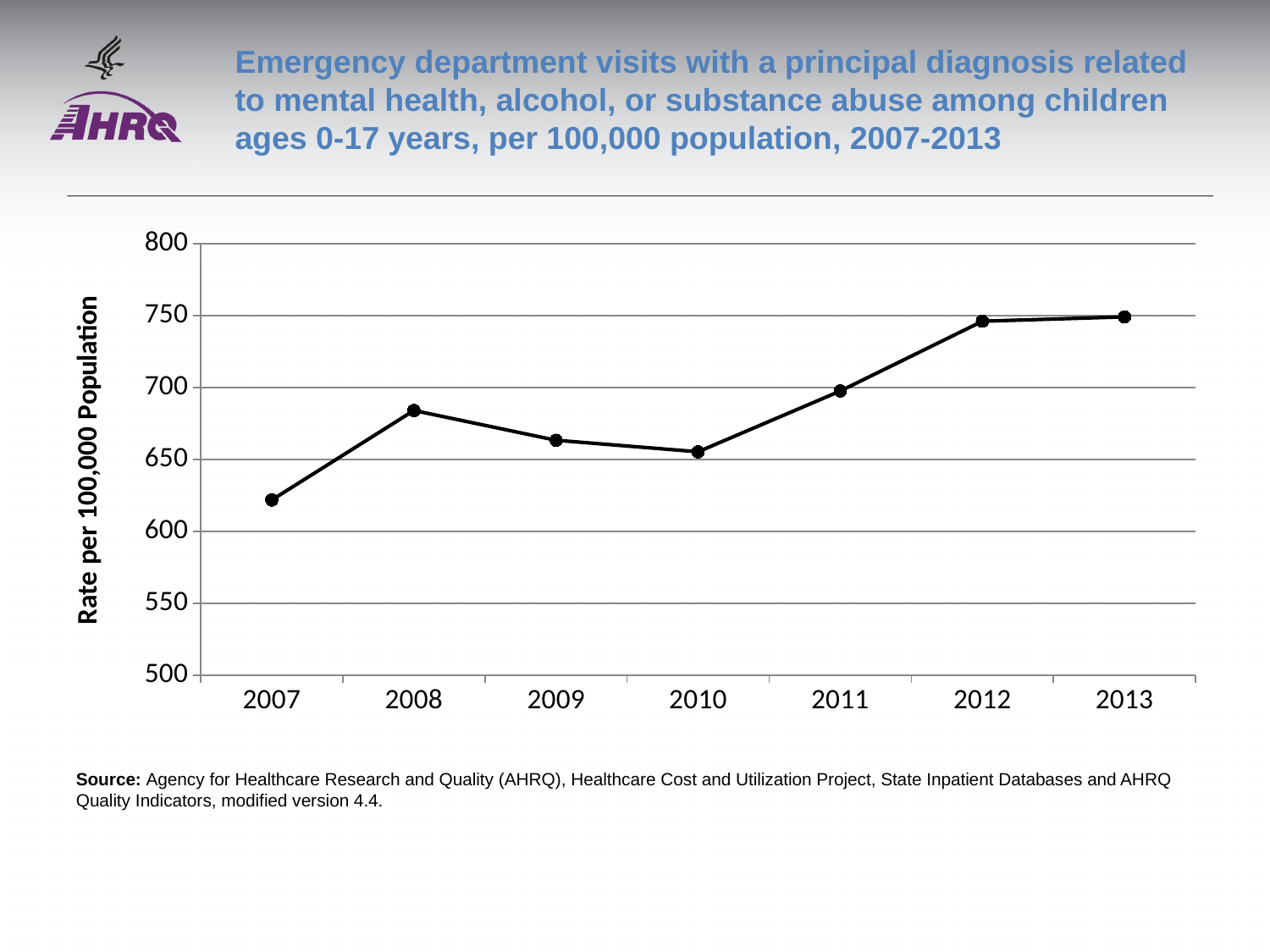
Is the value for 2012 greater or less than 700? greater Do the values rise or fall from 2010 to 2012? rise What kind of chart is shown on the slide? line chart Which year has the higher rate, 2008 or 2009? 2008 Is the value for 2009 greater or less than 700? less What is the label on the vertical axis of the chart? Rate per 100,000 Population Is the value for 2013 greater or less than 700? greater Which year has the higher rate, 2007 or 2011? 2011 Which year has the lowest rate on the chart? 2007 How many years (data points) are plotted on the chart? 7